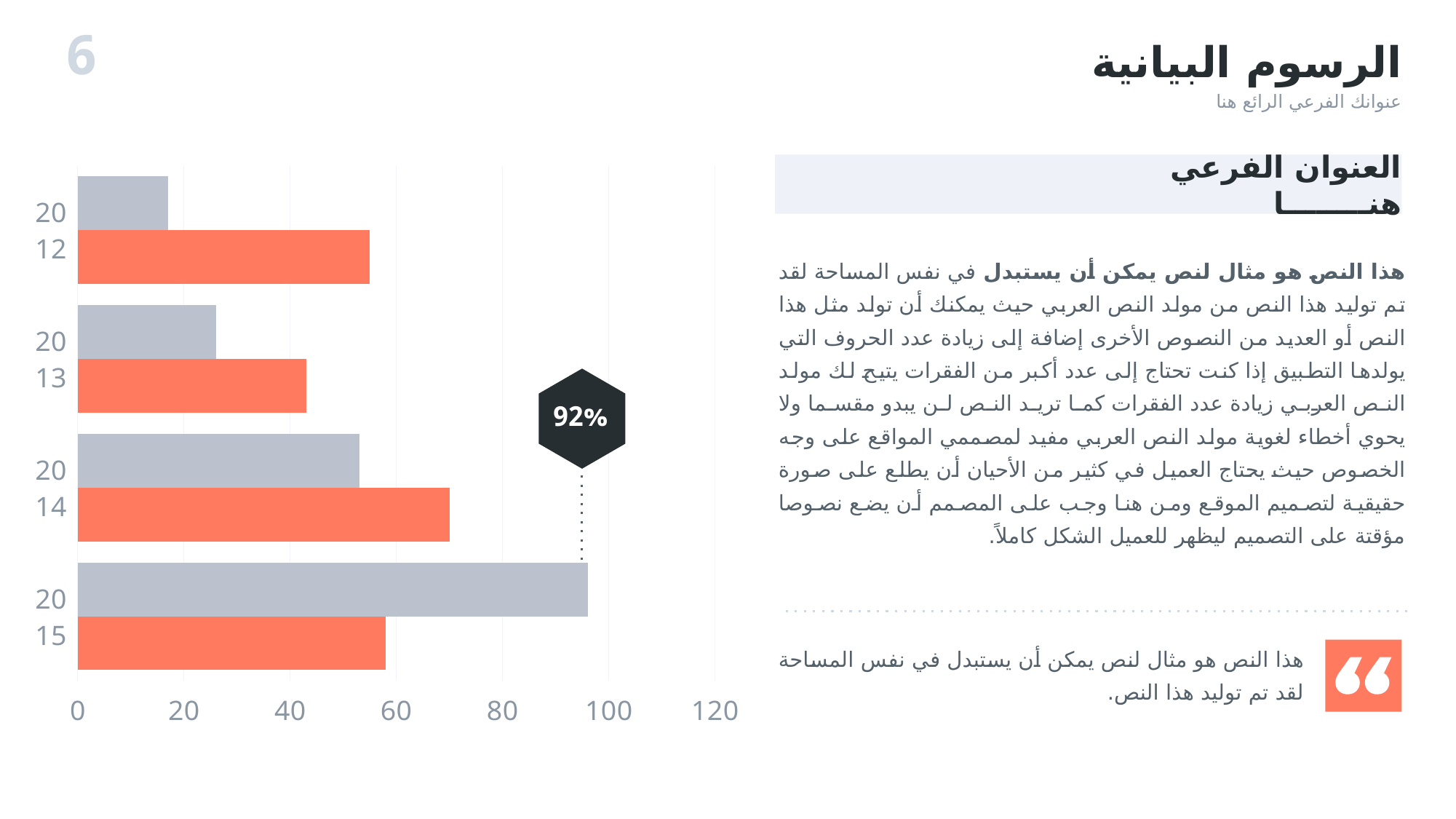
Is the grey bar for 2012 greater or less than 20? less For 2013, which bar is longer, the grey one or the orange one? orange Which year has the longest grey bar? 2015 What is the highest value shown on the horizontal axis? 120 Which year has the longest orange bar? 2014 How many bars are drawn for each year on the chart? 2 Do the grey bars rise or fall from 2012 to 2015? rise How many categories (years) are shown on the chart? 4 Which year has the shortest grey bar? 2012 Is the orange bar for 2014 greater or less than 60? greater Is the grey bar for 2015 greater or less than 80? greater What kind of chart is shown on the slide? bar chart